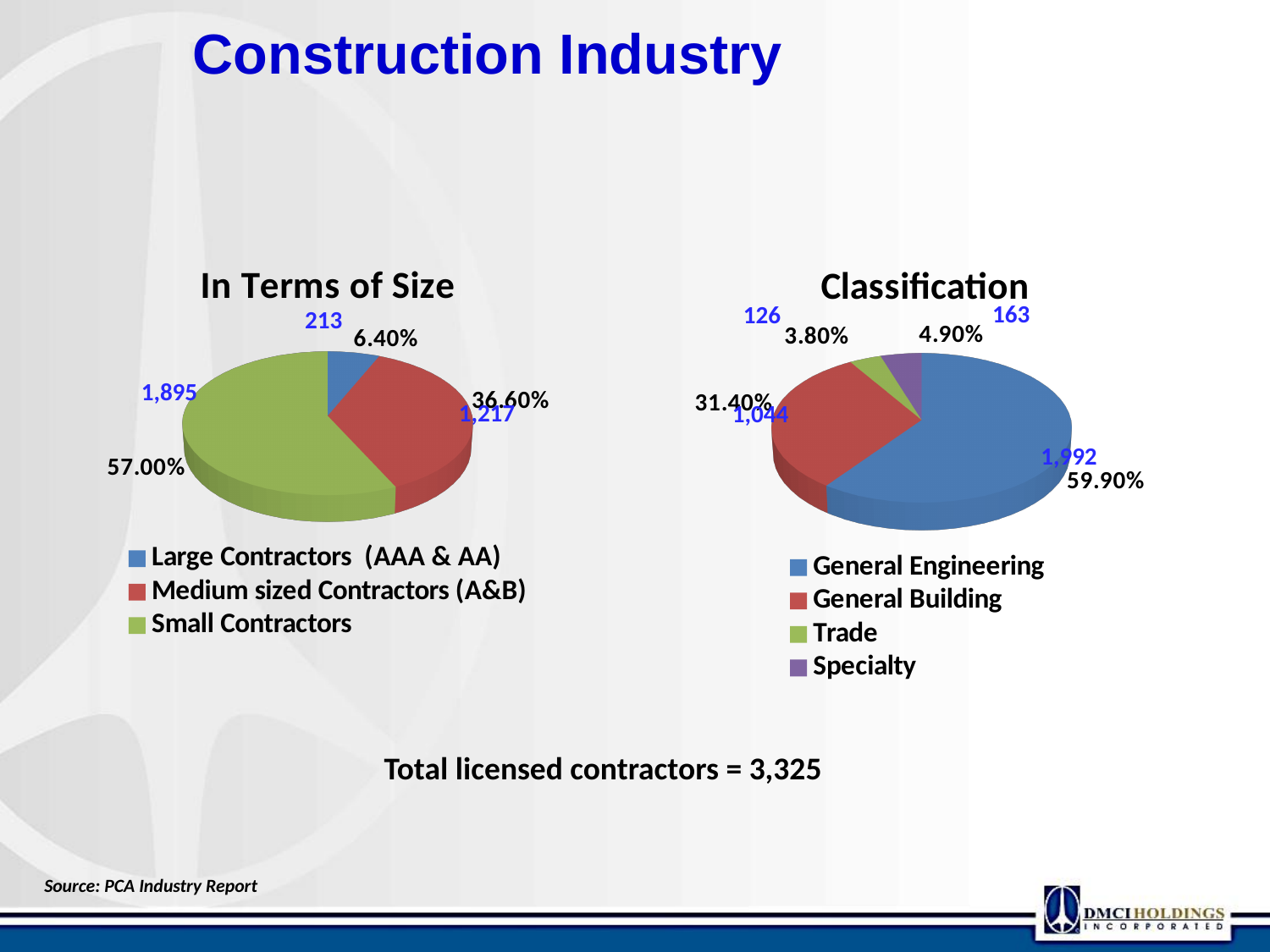
In the "Classification" chart, how many categories does the legend list? 4 In the "In Terms of Size" chart, how many Large Contractors (AAA & AA) are there? 213 In the "Classification" chart, which is larger, Trade or Specialty? Specialty In the "In Terms of Size" chart, what is the difference between the number of Small Contractors and Medium sized Contractors? 678 In the "Classification" chart, which category has the smallest slice? Trade In the "In Terms of Size" chart, which category has the largest slice? Small Contractors In the "In Terms of Size" chart, what share of the pie do Small Contractors represent? 57.00% In the "Classification" chart, what is the value for General Building? 1,044 In the "Classification" chart, what colour is the General Engineering slice? Blue What type of chart is the "In Terms of Size" chart? Pie chart In the "In Terms of Size" chart, what is the value for Medium sized Contractors (A&B)? 1,217 In the "Classification" chart, what share of the pie is General Engineering? 59.90%